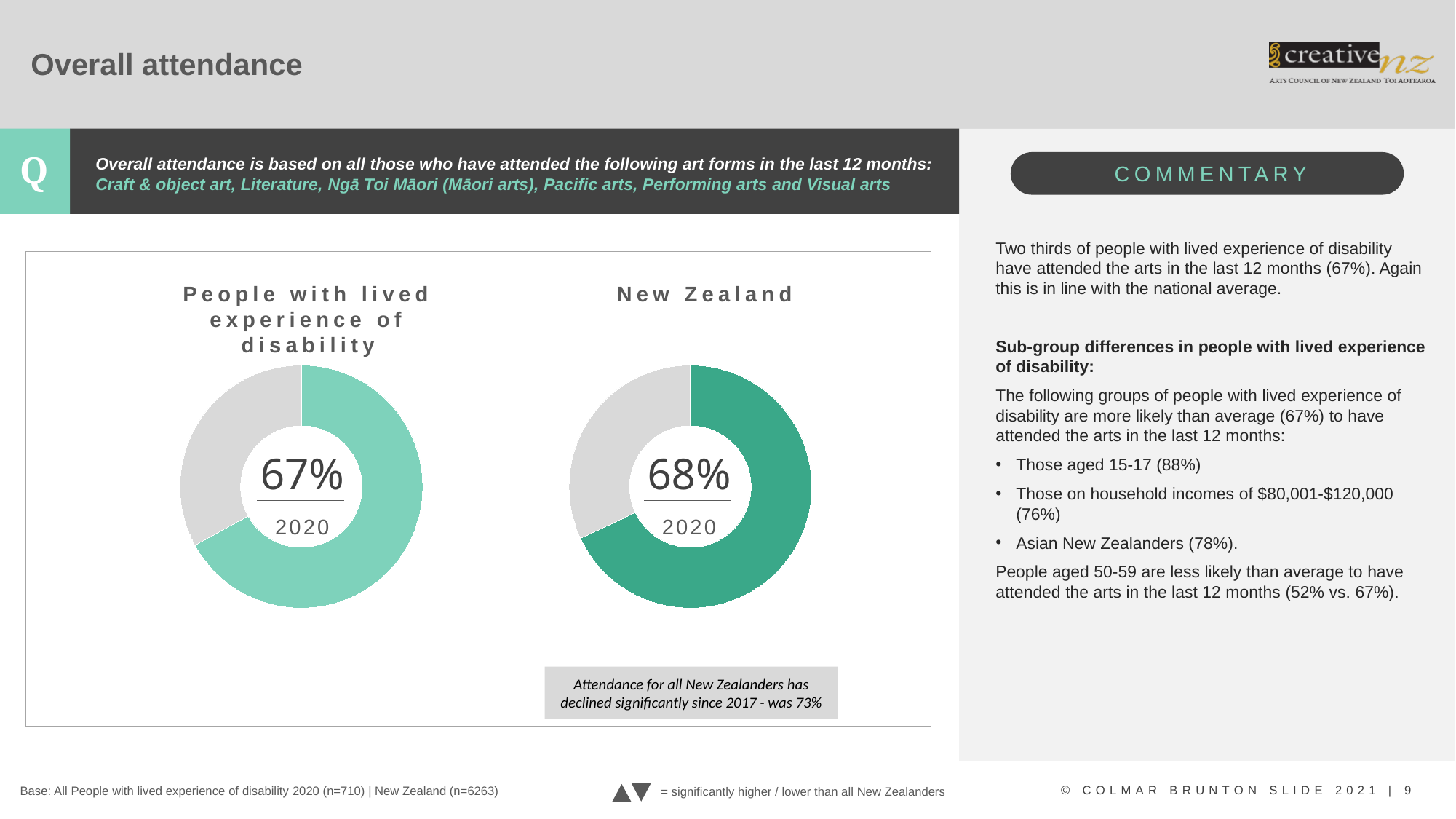
What kind of chart is used to show the attendance figures on this slide? Donut (pie) chart By how many percentage points has attendance for all New Zealanders declined from 2017 (73%) to 2020 (68%)? 5 percentage points In the 'New Zealand' donut chart, what percentage is shown in the centre? 68% Which chart shows the higher attendance value, 'People with lived experience of disability' or 'New Zealand'? New Zealand Is the value in the 'People with lived experience of disability' donut chart greater or less than 50%? greater What is the difference in percentage points between the 'New Zealand' value (68%) and the 'People with lived experience of disability' value (67%)? 1 percentage point What year is labelled beneath the percentage in the 'New Zealand' donut chart? 2020 What year is labelled beneath the percentage in the 'People with lived experience of disability' donut chart? 2020 In the 'People with lived experience of disability' donut chart, what percentage is shown in the centre? 67% What is the title of the left-hand donut chart? People with lived experience of disability According to the note under the 'New Zealand' chart, what was attendance for all New Zealanders in 2017? 73% How many donut charts are shown on the slide? 2